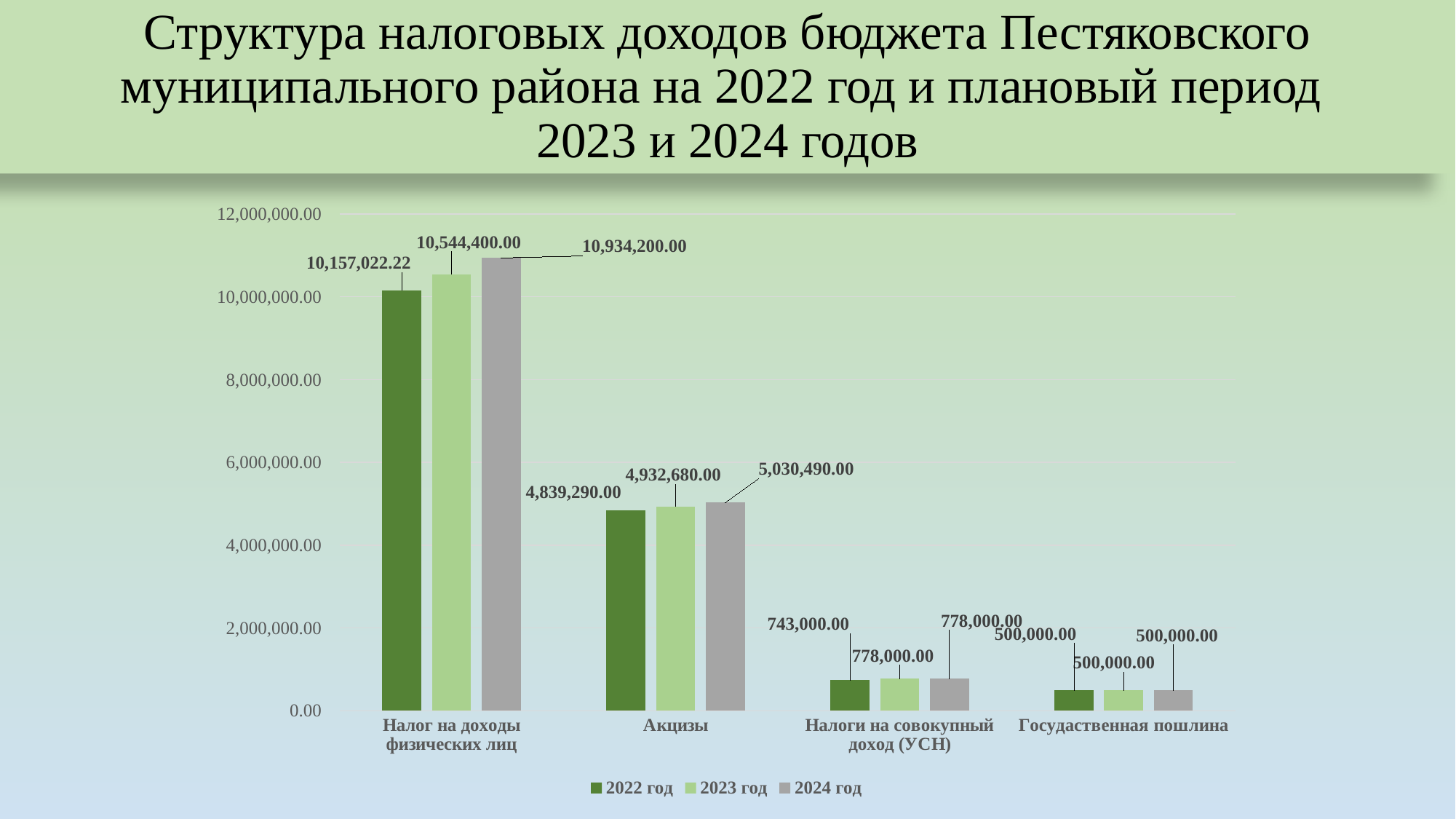
Which category has the lowest value in 2023 год? Государственная пошлина Which category has the highest value in 2024 год? Налог на доходы физических лиц What is the value for Акцизы in 2024 год? 5,030,490.00 Do the values for Налог на доходы физических лиц rise or fall from 2022 год to 2024 год? Rise What is the value for Налог на доходы физических лиц in 2022 год? 10,157,022.22 What type of chart is shown on the slide? Bar chart Which is larger: the 2023 год value for Акцизы or the 2022 год value for Налог на доходы физических лиц? 2022 год value for Налог на доходы физических лиц What is the difference between the 2024 год and 2022 год values for Акцизы? 191,200.00 How many series does the legend list? 3 What is the value for Государственная пошлина in 2022 год? 500,000.00 How many categories are shown on the x axis? 4 What is the value for Налоги на совокупный доход (УСН) in 2023 год? 778,000.00